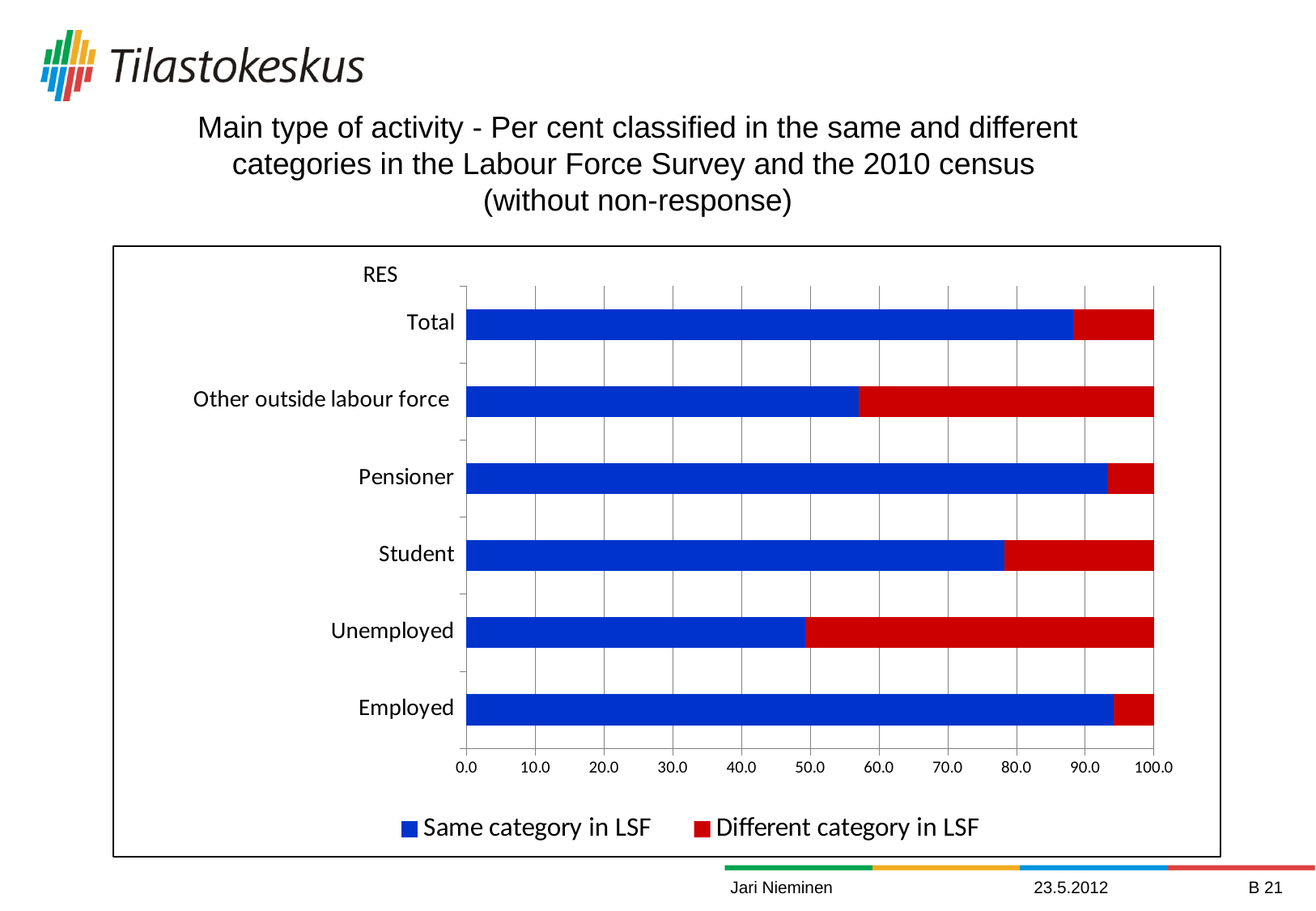
How many series does the legend list? 2 How many categories are plotted on the vertical axis of the chart? 6 What is the total of the stacked bar for Employed? 100.0 Is the 'Same category in LSF' value for Pensioner greater or less than 90.0? greater Which category has the lowest share classified in the same category in LSF? Unemployed Is the 'Same category in LSF' value for Student greater or less than 70.0? greater Which colour represents 'Different category in LSF' in the chart? Red What kind of chart is shown on the slide? Stacked bar chart Is the 'Same category in LSF' value for Unemployed greater or less than 60.0? less Which category has the largest share classified in a different category in LSF? Unemployed Which has a larger 'Same category in LSF' share, Student or Other outside labour force? Student